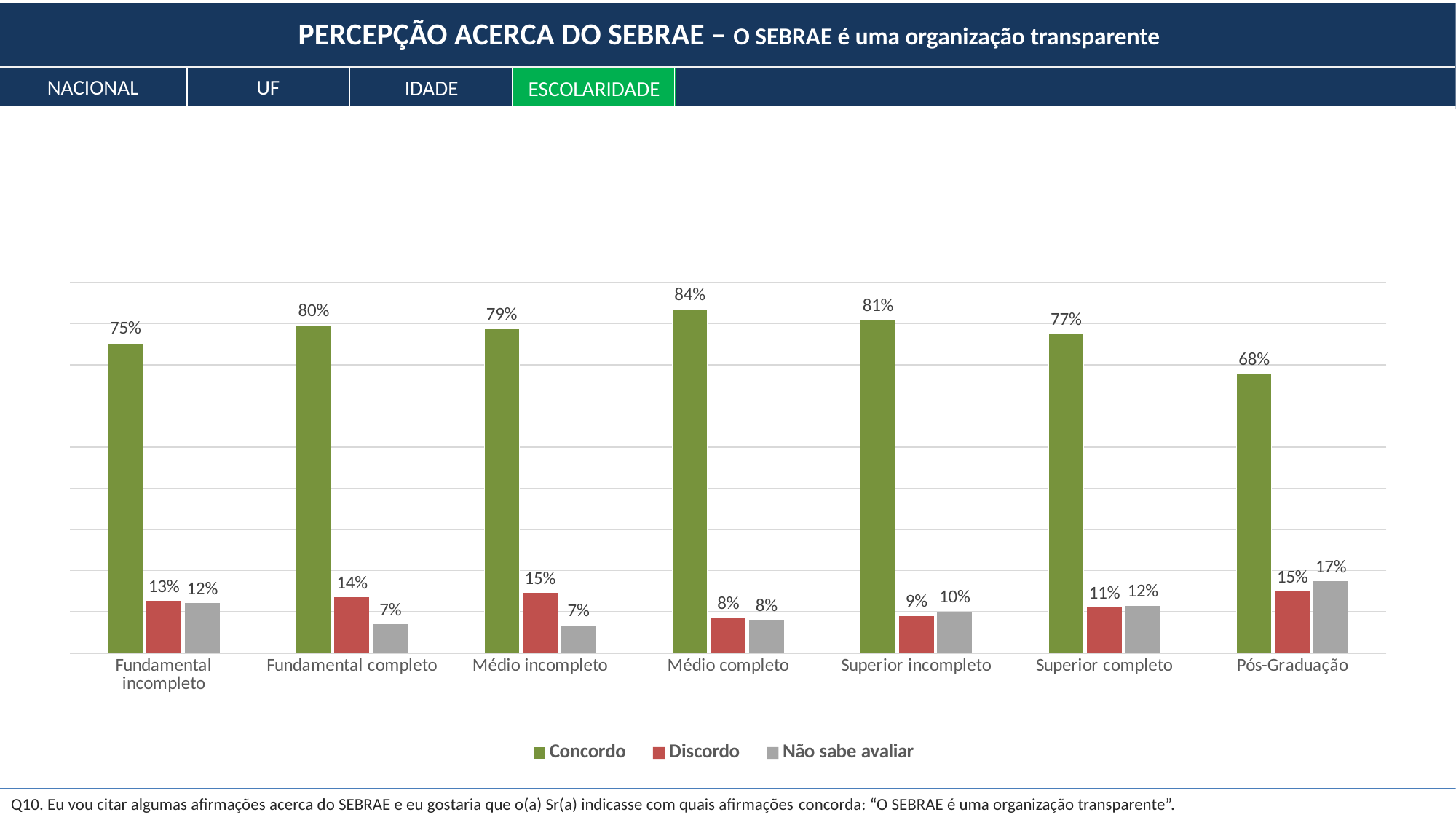
How many series does the legend list? 3 What is the Discordo value for Fundamental completo? 14% Which is larger, the Discordo value for Médio incompleto or the Discordo value for Superior incompleto? Médio incompleto Which category has the highest Concordo value? Médio completo What kind of chart is shown? Bar chart What is the Não sabe avaliar value for Pós-Graduação? 17% What is the Concordo value for Médio completo? 84% What is the difference between the Concordo values for Médio completo and Pós-Graduação? 16% What is the total of Discordo and Não sabe avaliar for Superior completo? 23% Which colour represents the Concordo series? Green Which category has the lowest Concordo value? Pós-Graduação How many education categories are shown on the x axis? 7